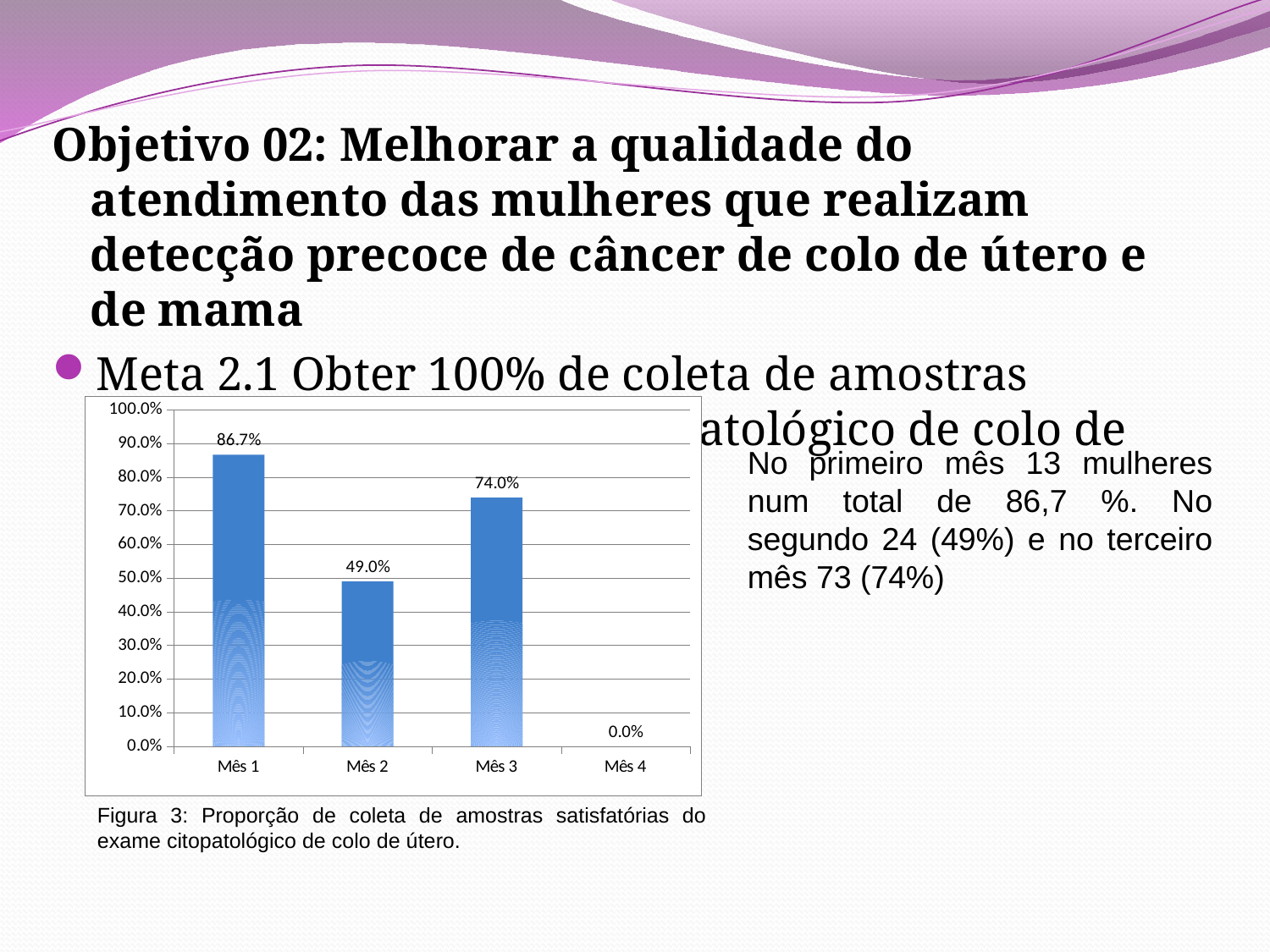
Is the value for Mês 1 greater or less than 80.0%? greater What is the value for Mês 2? 49.0% What kind of chart is shown? bar chart What is the value for Mês 1? 86.7% What is the value for Mês 4? 0.0% How many months are shown on the x axis? 4 Which is larger, the value for Mês 2 or the value for Mês 3? Mês 3 What is the difference between the values for Mês 1 and Mês 2? 37.7% What is the value for Mês 3? 74.0% What is the difference between the values for Mês 3 and Mês 2? 25.0% Which month has the highest value? Mês 1 Which month has the lowest value? Mês 4